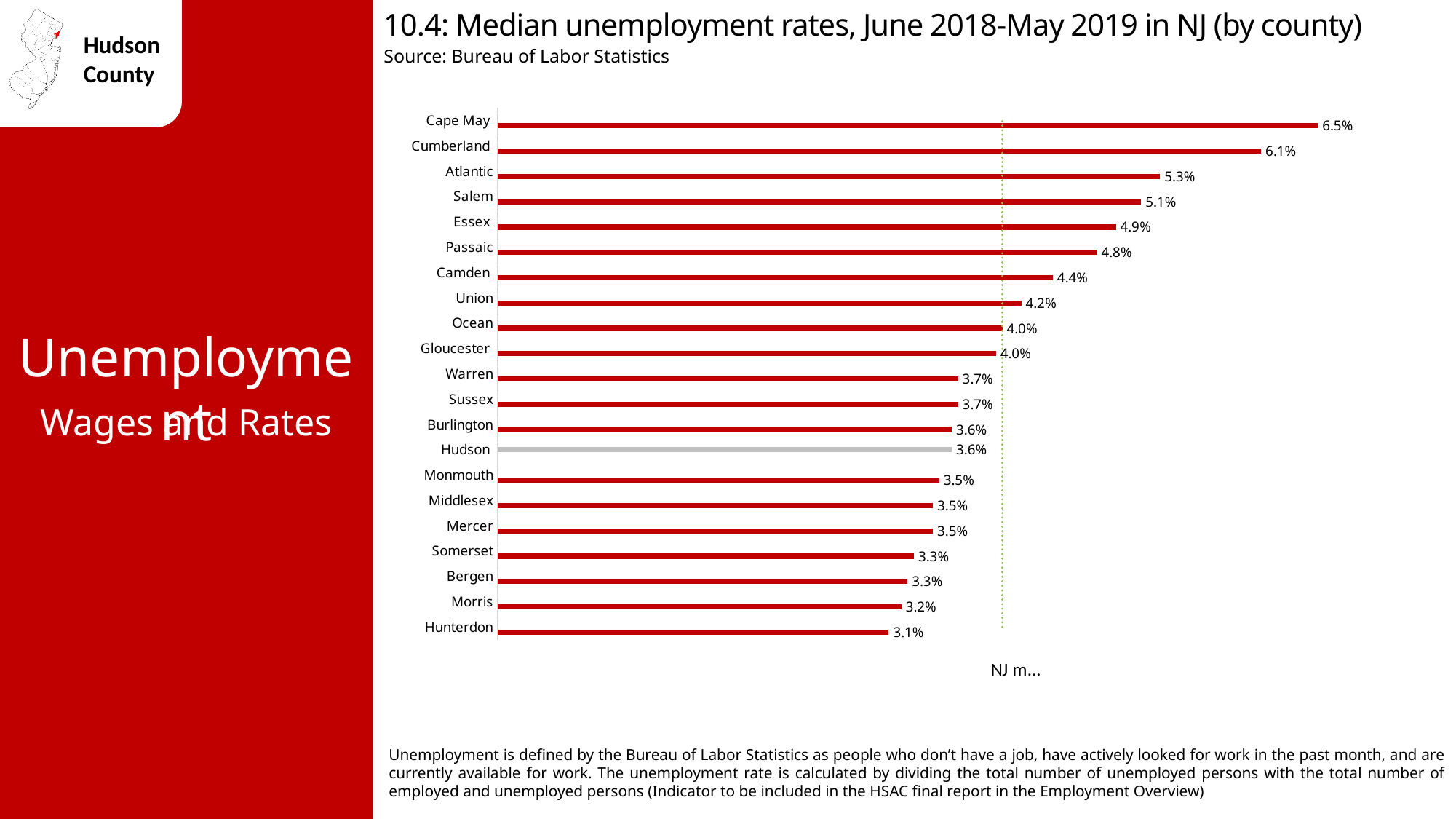
What is the difference between the median unemployment rates of Cape May and Hunterdon? 3.4% Which county has the lowest median unemployment rate? Hunterdon Which county has a higher median unemployment rate, Union or Morris? Union How many counties are shown in the chart? 21 What type of chart is used to show the median unemployment rates? Bar chart What is the median unemployment rate for Hudson County? 3.6% Which county's bar is shown in grey rather than red? Hudson What is the median unemployment rate for Camden? 4.4% Which county has the highest median unemployment rate? Cape May What is the difference between the median unemployment rates of Cumberland and Hudson? 2.5% Which county has a higher median unemployment rate, Essex or Passaic? Essex What is the median unemployment rate for Cape May? 6.5%